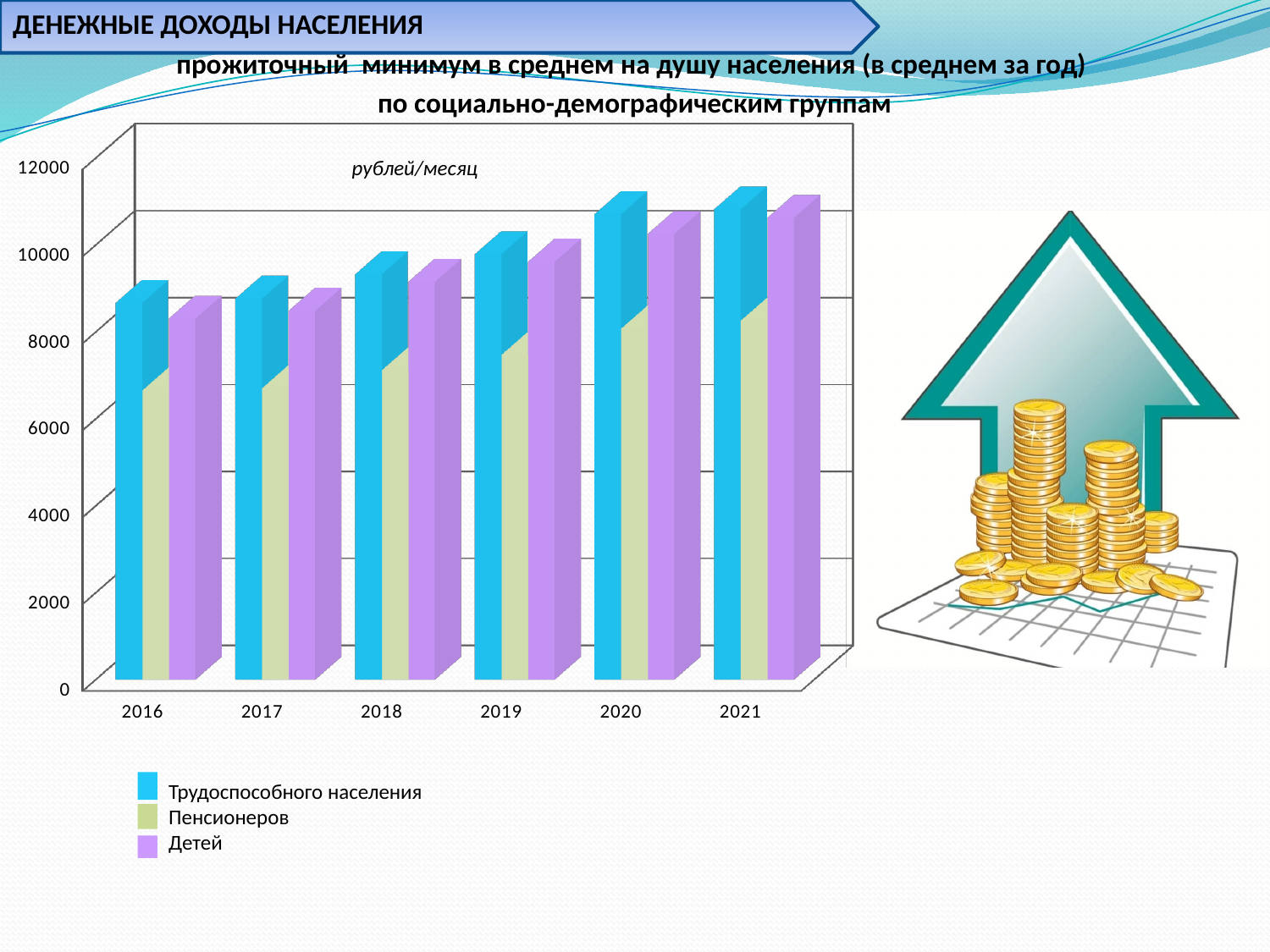
Which series is shown in blue in the chart? Трудоспособного населения Is the value for Пенсионеров in 2016 greater or less than 8000? less How many years are shown on the x axis of the chart? 6 Is the value for Пенсионеров in 2021 greater or less than 8000? greater How many series does the chart legend list? 3 Do the values for Детей rise or fall from 2016 to 2021? rise Is the value for Трудоспособного населения in 2016 greater or less than 8000? greater What kind of chart is shown on the slide? bar chart What unit is indicated on the chart? рублей/месяц Which is larger in 2019: the value for Трудоспособного населения or for Пенсионеров? Трудоспособного населения